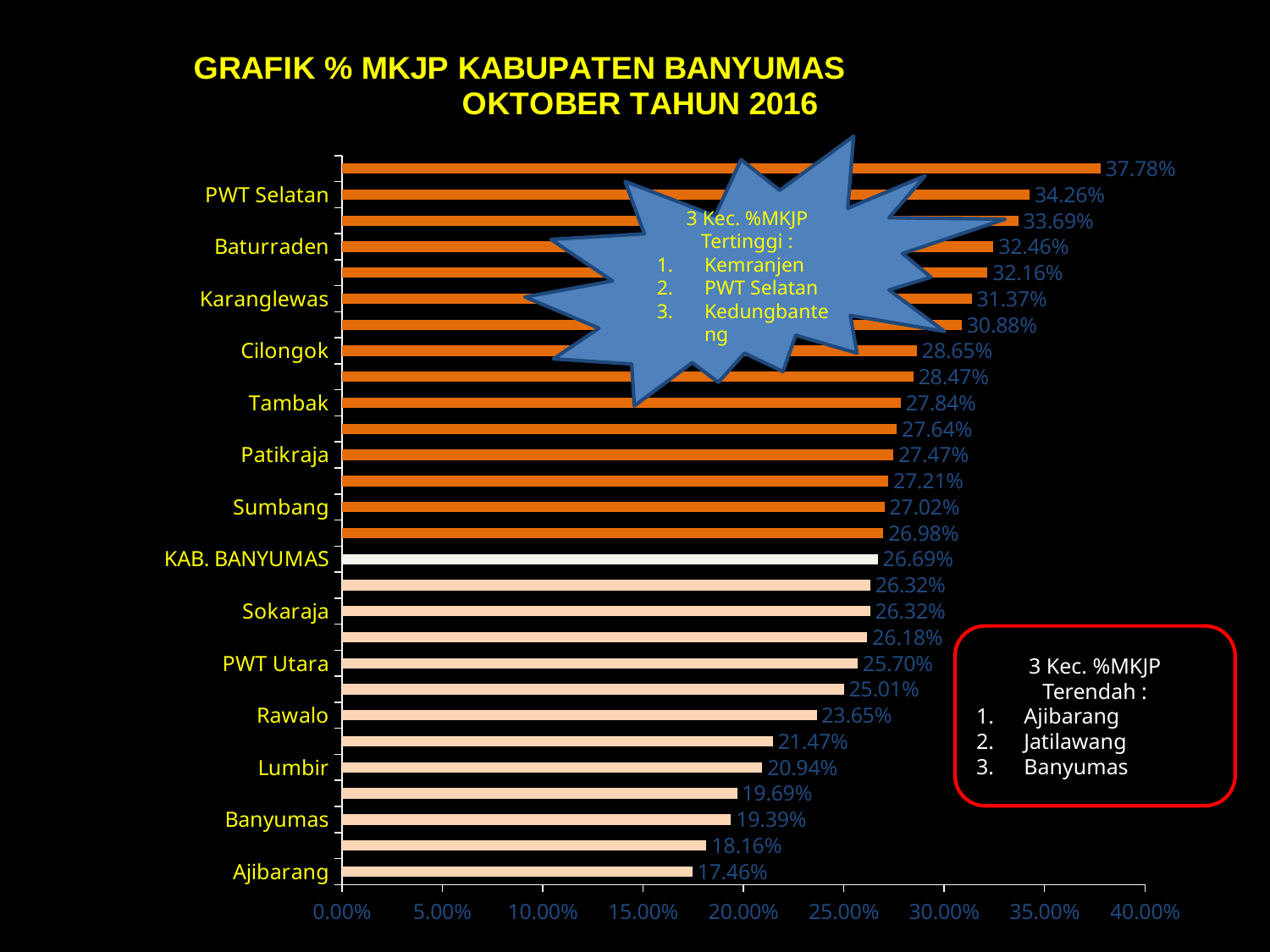
What is the title of the chart? GRAFIK % MKJP KABUPATEN BANYUMAS OKTOBER TAHUN 2016 Which labelled category has the lowest % MKJP value? Ajibarang What is the highest value printed on the chart? 37.78% Which has a higher value, Baturraden or Karanglewas? Baturraden What is the % MKJP value for Ajibarang? 17.46% Is the value for Lumbir greater or less than 25.00%? less How many bars are plotted on the chart? 28 What is the % MKJP value for PWT Selatan? 34.26% What is the difference between the values for PWT Selatan and Ajibarang? 16.80% What is the value shown for Rawalo? 23.65% What is the value shown for KAB. BANYUMAS? 26.69% What type of chart is shown on the slide? Bar chart